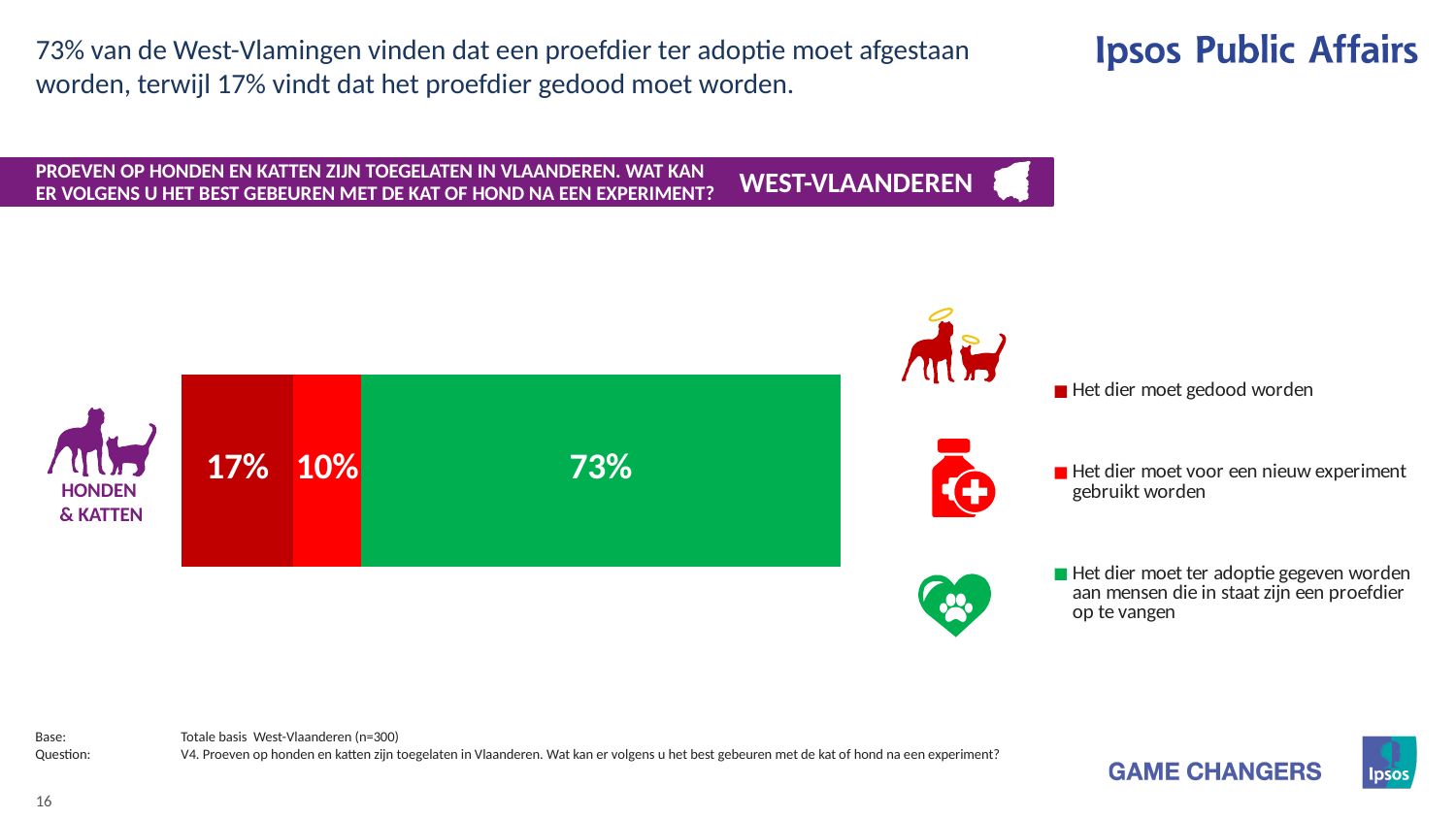
Which response option has the highest share in the bar? Het dier moet ter adoptie gegeven worden aan mensen die in staat zijn een proefdier op te vangen Which is larger: the share saying the animal should be killed or the share saying it should be used for a new experiment? Het dier moet gedood worden What is the difference in percentage points between the adoption share and the share saying the animal should be killed? 56 What colour is the segment for "Het dier moet ter adoptie gegeven worden"? Green What percentage of respondents say the animal should be used for a new experiment ("Het dier moet voor een nieuw experiment gebruikt worden")? 10% How many series does the legend list? 3 Which response option has the lowest share in the bar? Het dier moet voor een nieuw experiment gebruikt worden What percentage of respondents say the animal should be killed ("Het dier moet gedood worden")? 17% What kind of chart is shown on the slide? Stacked bar chart What percentage of respondents say the animal should be put up for adoption ("Het dier moet ter adoptie gegeven worden")? 73% What is the total of the three segments in the stacked bar? 100% Which region does the chart cover, according to the label next to the question text? West-Vlaanderen